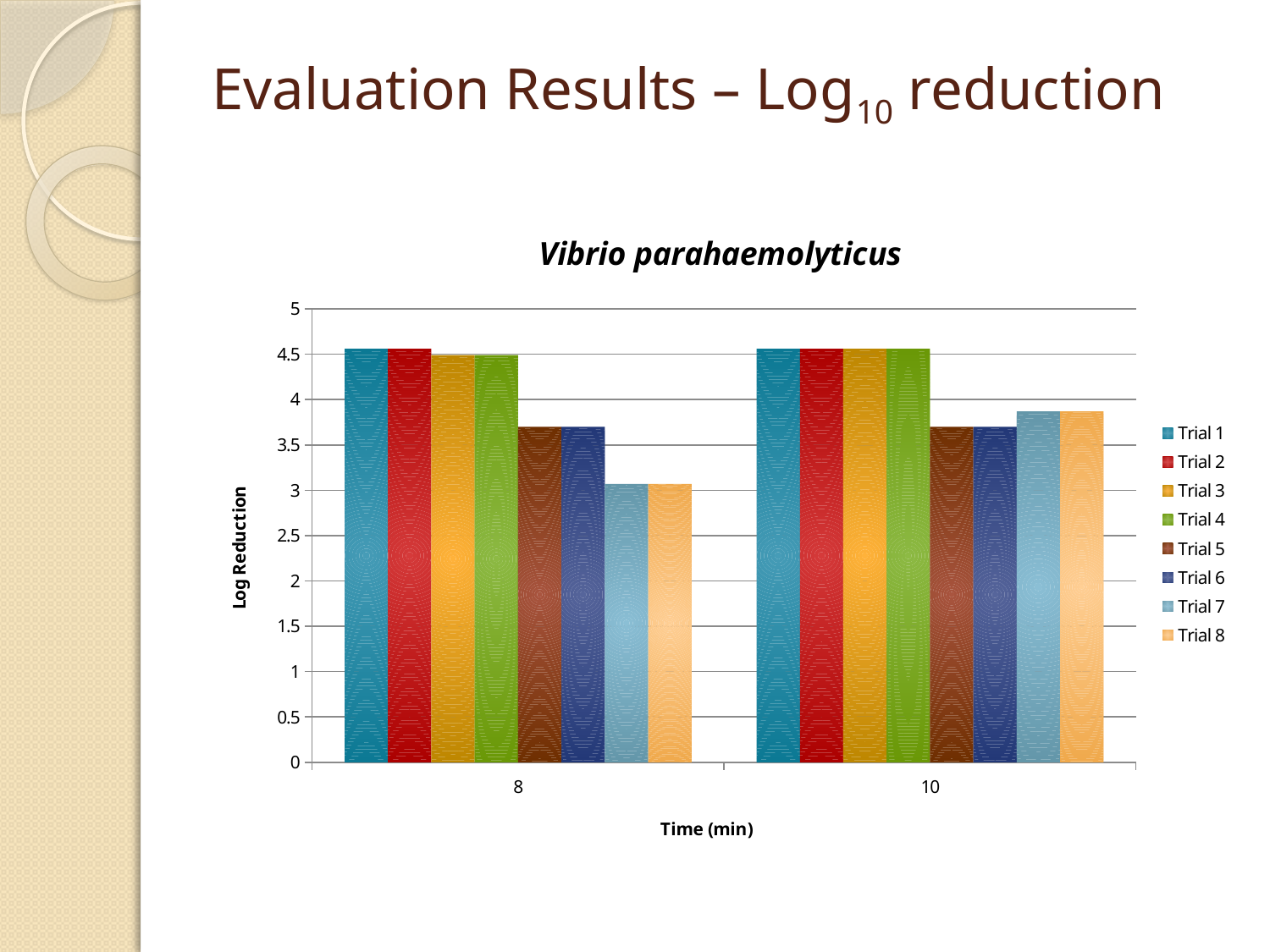
How many series does the legend list? 8 How many time categories are shown on the x axis? 2 Is the value for Trial 8 at 10 min greater or less than 4? less What kind of chart is shown on the slide? bar chart What is the title of the chart? Vibrio parahaemolyticus What is the label of the y axis? Log Reduction Is the value for Trial 5 at 8 min greater or less than 3.5? greater For Trial 7, which time has the larger log reduction, 8 min or 10 min? 10 Is the value for Trial 1 at 8 min greater or less than 4? greater At 8 min, which is larger, the value for Trial 1 or the value for Trial 7? Trial 1